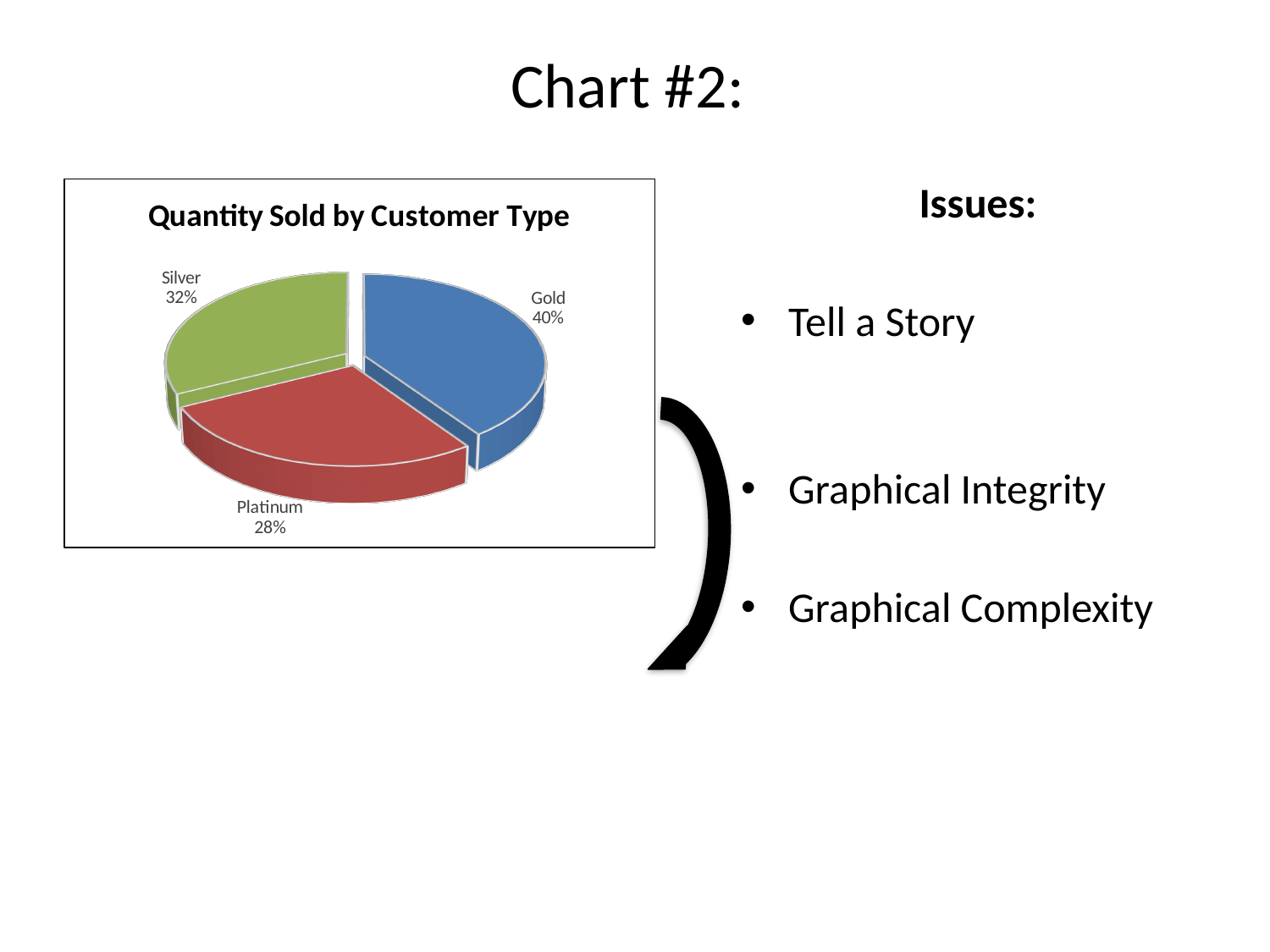
What colour is the Gold slice of the pie? blue What share of the pie does Gold represent? 40% What is the title of the chart? Quantity Sold by Customer Type What kind of chart is shown on the slide? pie chart Which customer type has the smallest share of quantity sold? Platinum What share of the pie does Platinum represent? 28% Which has a larger share, Silver or Platinum? Silver What share of the pie does Silver represent? 32% What is the difference in percentage points between the Silver and Platinum shares? 4% What is the difference in percentage points between the Gold and Platinum shares? 12% Which customer type has the largest share of quantity sold? Gold How many customer types are shown in the pie chart? 3